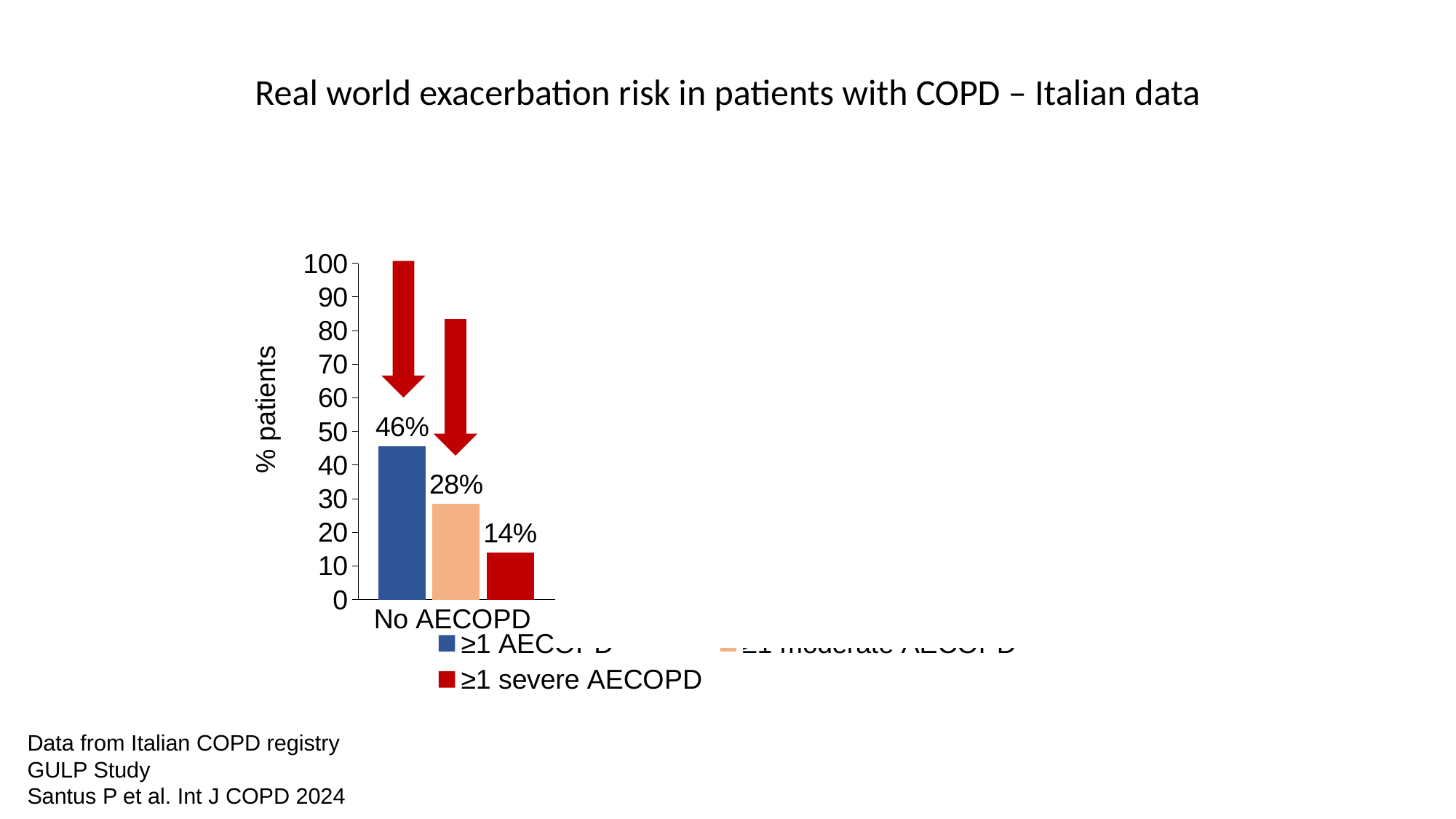
Which series has the highest value in the chart? ≥1 AECOPD What percentage of patients had ≥1 moderate AECOPD? 28% Is the value for ≥1 AECOPD greater or less than 50? less Which series has the lowest value in the chart? ≥1 severe AECOPD What is the label of the y axis? % patients How many series does the legend list? 3 What is the difference between the ≥1 AECOPD value and the ≥1 severe AECOPD value? 32% What is the difference between the ≥1 AECOPD value and the ≥1 moderate AECOPD value? 18% What percentage of patients had ≥1 AECOPD? 46% Which is larger, the value for ≥1 moderate AECOPD or the value for ≥1 severe AECOPD? ≥1 moderate AECOPD What percentage of patients had ≥1 severe AECOPD? 14% What kind of chart is shown on the slide? Bar chart